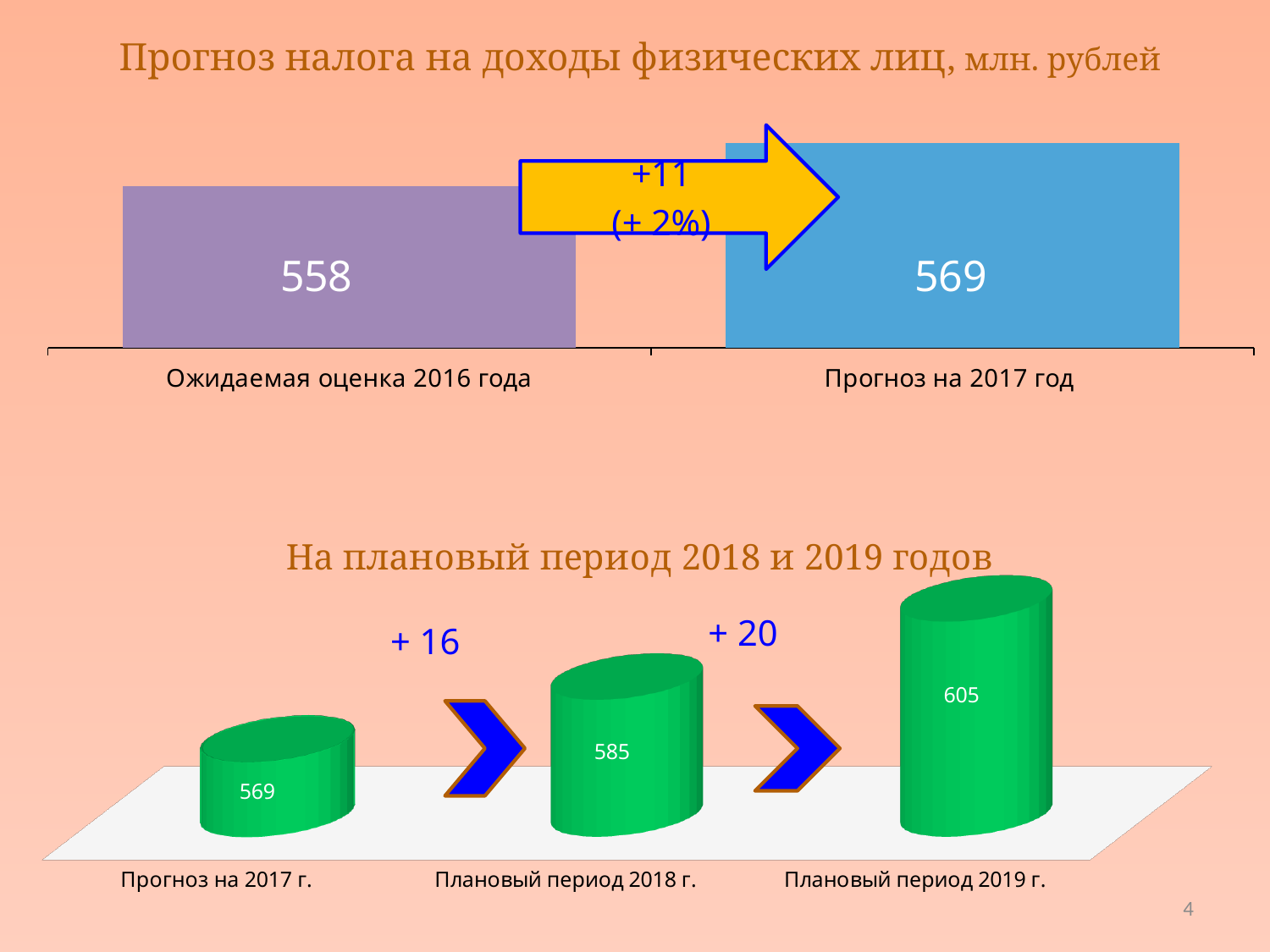
In the top chart, what is the difference between Прогноз на 2017 год and Ожидаемая оценка 2016 года? 11 In the top chart, what is the value for Прогноз на 2017 год? 569 In the bottom chart (На плановый период 2018 и 2019 годов), do the values rise or fall from left to right? rise In the bottom chart (На плановый период 2018 и 2019 годов), what is the difference between Плановый период 2019 г. and Плановый период 2018 г.? 20 In the bottom chart (На плановый период 2018 и 2019 годов), what is the value for Плановый период 2018 г.? 585 What kind of chart is the top chart? bar chart In the top chart, which is larger: Ожидаемая оценка 2016 года or Прогноз на 2017 год? Прогноз на 2017 год In the top chart, what is the value for Ожидаемая оценка 2016 года? 558 In the bottom chart (На плановый период 2018 и 2019 годов), which category has the highest value? Плановый период 2019 г. In the bottom chart (На плановый период 2018 и 2019 годов), which category has the lowest value? Прогноз на 2017 г. In the bottom chart (На плановый период 2018 и 2019 годов), what is the value for Плановый период 2019 г.? 605 How many categories does the top chart show? 2